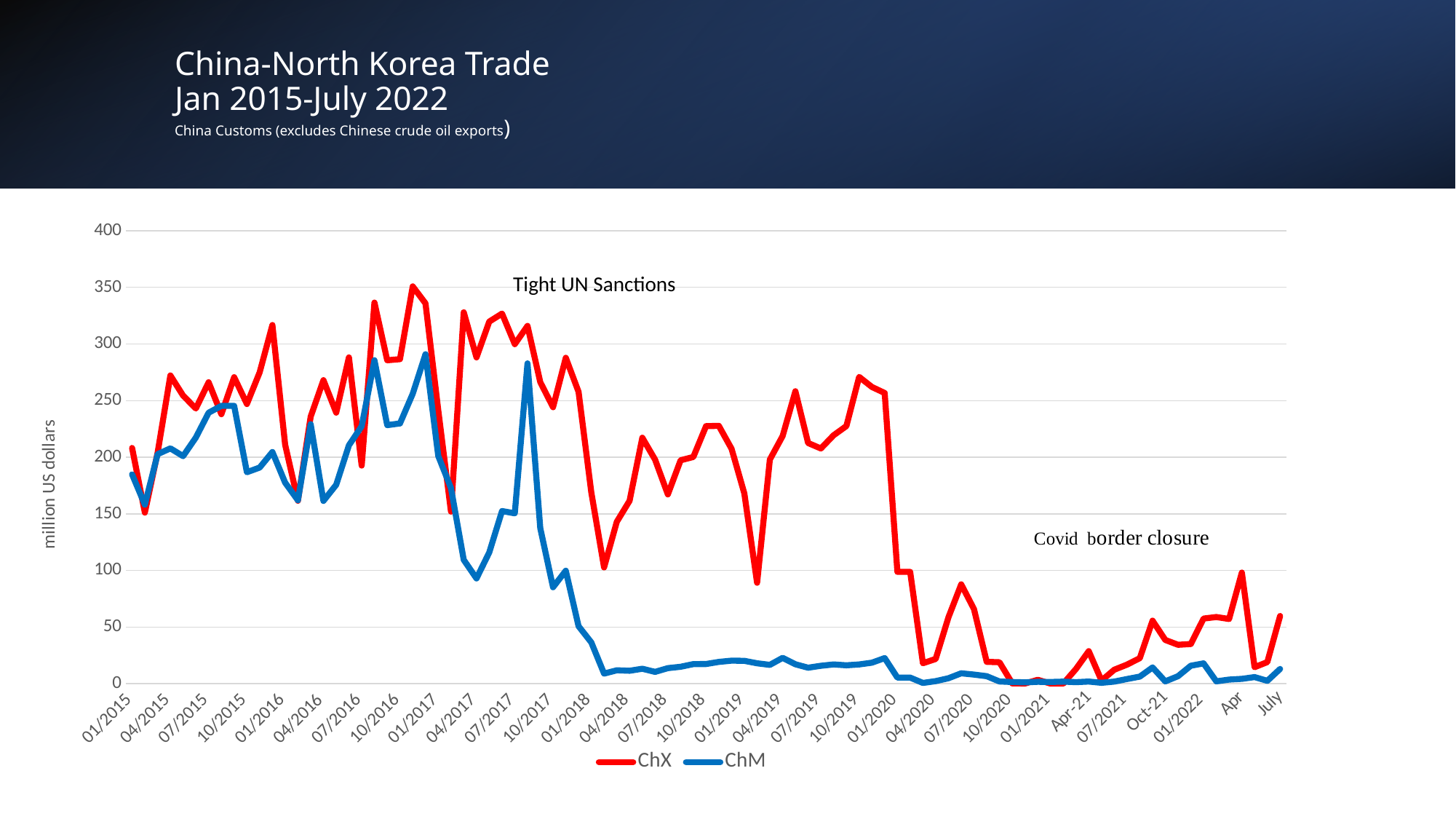
Is the value for ChM at 01/2021 greater or less than 50? less Is the value for ChX at 10/2019 greater or less than 250? greater How many series does the legend list? 2 At 07/2019, which series has the larger value, ChX or ChM? ChX Is the value for ChM at 04/2018 greater or less than 50? less Does the ChX series rise or fall between 10/2019 and 04/2020? fall Does the ChM series rise or fall between 01/2018 and 04/2018? fall What is the label on the vertical axis? million US dollars What kind of chart is shown on the slide? line chart What are the two series named in the legend? ChX and ChM